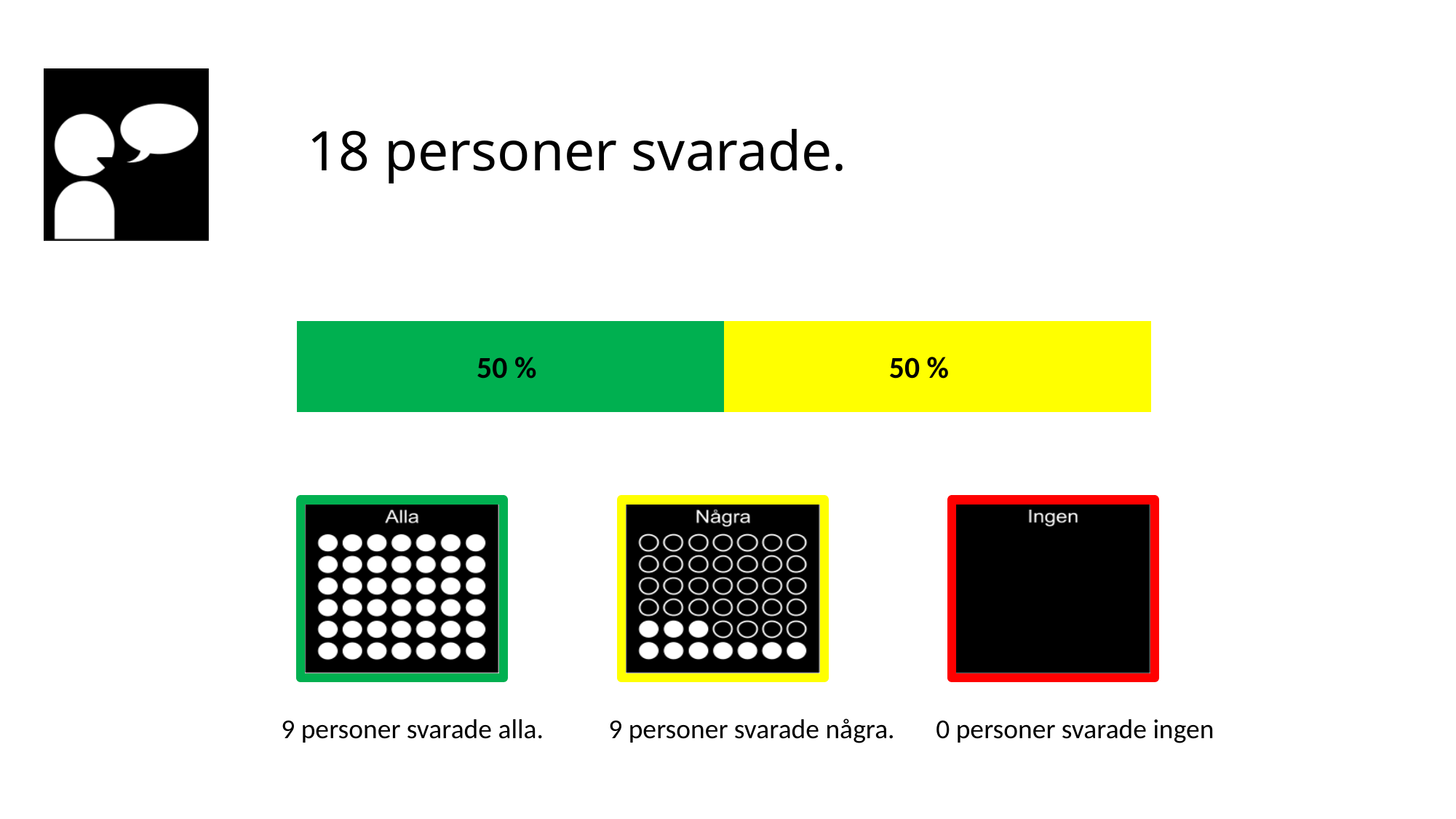
What is the difference between the green segment and the yellow segment of the bar? 0 % What colour is the segment of the bar on the left? green How many people answered 'alla' according to the slide? 9 How many people answered in total, according to the slide title? 18 What value is printed on the green segment of the bar? 50 % What value is printed on the yellow segment of the bar? 50 % Which answer category has the lowest number of people: Alla, Några or Ingen? Ingen How many people answered 'några' according to the slide? 9 What kind of chart is shown on the slide? bar chart How many people answered 'ingen' according to the slide? 0 How many segments does the horizontal bar have? 2 What is the total of the two segments of the bar? 100 %